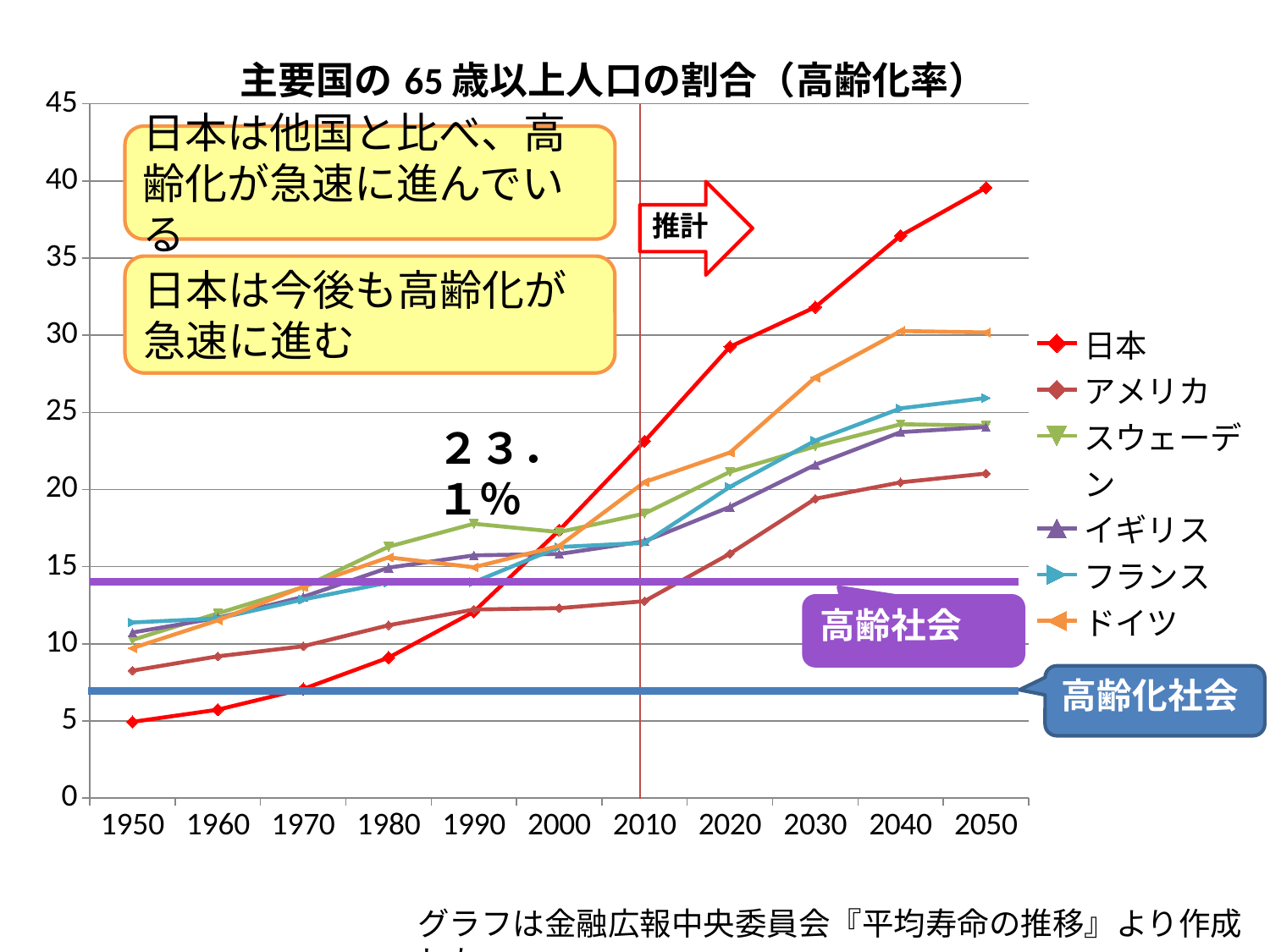
Which country has the lowest value in 1950? 日本 Which country has the lowest value in 2050? アメリカ What value is labelled for 日本 in 2010? ２３．１％ What is the title of the chart? 主要国の65歳以上人口の割合（高齢化率） How many series does the legend list? 6 Does the line for 日本 rise or fall from 1950 to 2050? rise Which country has the highest value in 2050? 日本 Is the value for アメリカ in 2050 greater or less than 25? less In 2050, which is higher, ドイツ or フランス? ドイツ Is the value for 日本 in 2050 greater or less than 35? greater What kind of chart is shown on the slide? line chart How many years are shown along the x axis? 11